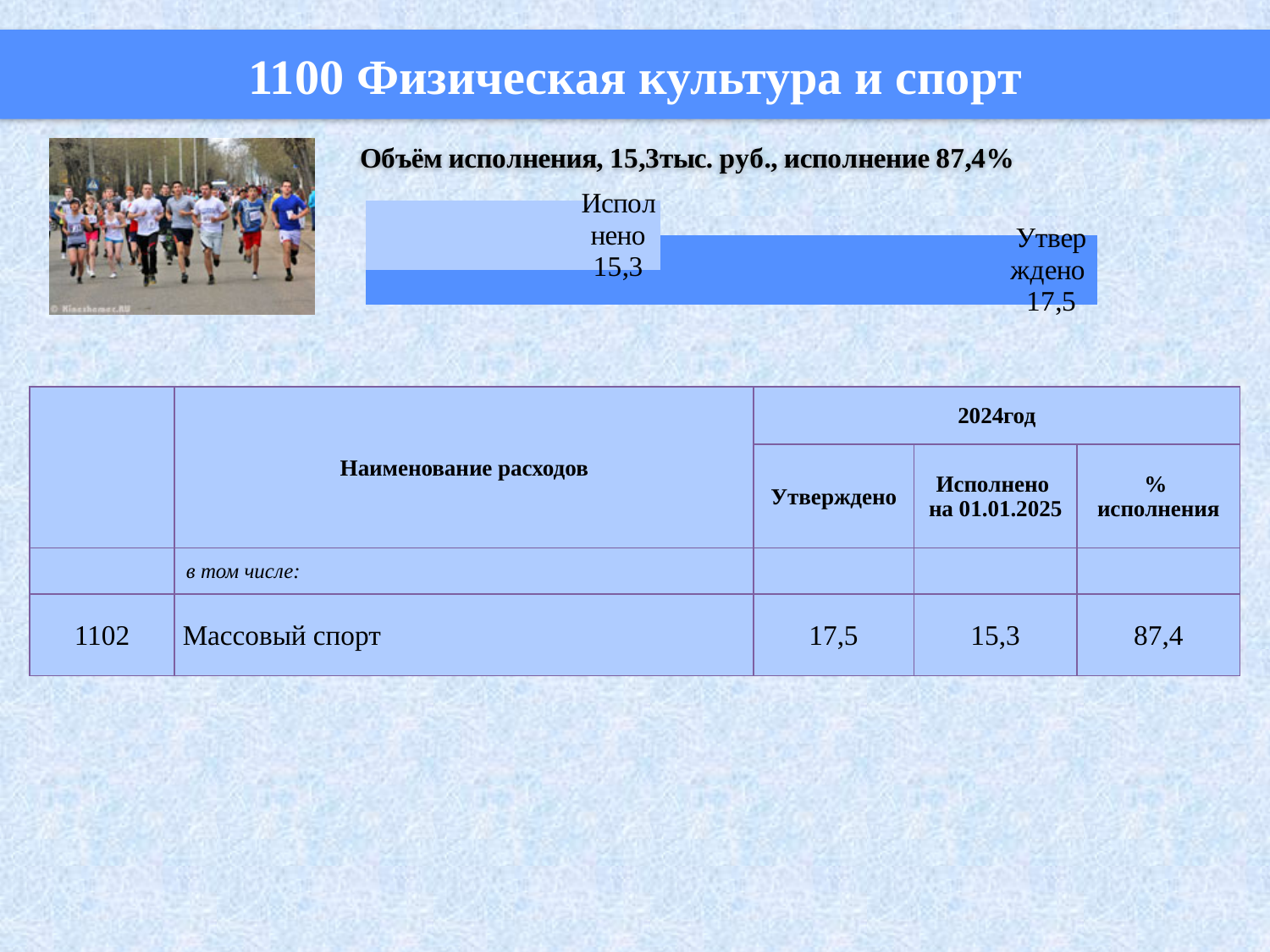
Which bar in the chart has the smallest value? Исполнено How many bars are plotted in the chart? 2 What is the difference between the Утверждено value and the Исполнено value? 2,2 Which bar has the higher value, Исполнено or Утверждено? Утверждено Which bar in the chart has the largest value? Утверждено Which bar is drawn in the lighter blue colour? Исполнено What is the value of the bar labelled Исполнено? 15,3 What is the title shown above the chart? Объём исполнения, 15,3тыс. руб., исполнение 87,4% What kind of chart is shown on the slide? bar chart What is the value of the bar labelled Утверждено? 17,5